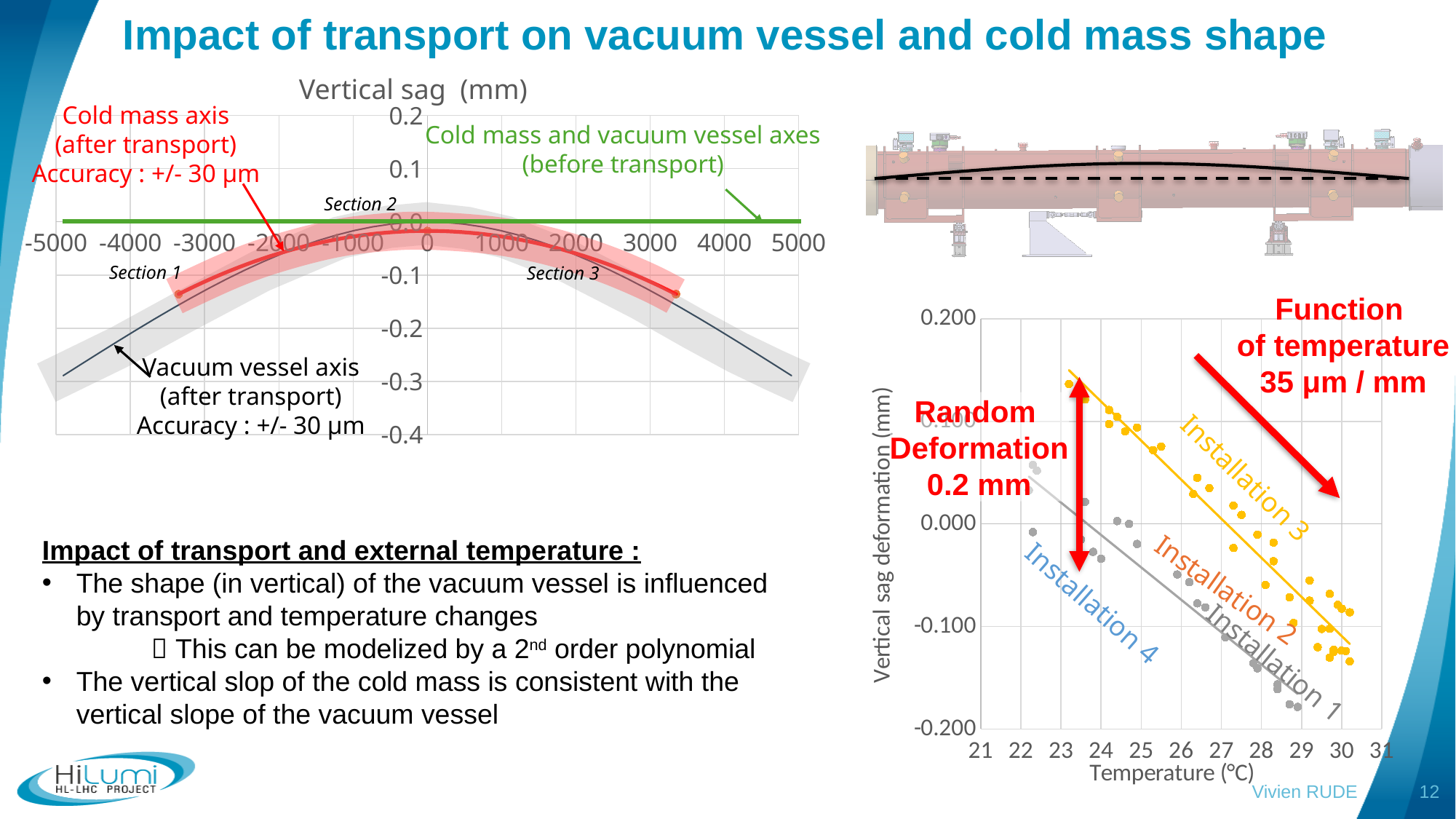
In the right chart, how many installations are labelled? 4 In the left chart, is the cold mass axis (after transport) value at x = 0 greater or less than -0.1? greater What kind of chart is the left chart titled 'Vertical sag (mm)'? line chart In the left chart, what is the highest value shown on the vertical axis? 0.2 In the left chart, what vertical sag value does the green 'Cold mass and vacuum vessel axes (before transport)' line sit at? 0.0 In the right chart, what is the title of the x axis? Temperature (°C) In the right chart, what is the title of the y axis? Vertical sag deformation (mm) In the right chart, do the vertical sag deformation values rise or fall as temperature increases? fall What kind of chart is the right chart plotting vertical sag deformation against temperature? scatter chart In the right chart, at 25 °C, which has the larger vertical sag deformation: Installation 3 or Installation 1? Installation 3 In the left chart, is the vacuum vessel axis (after transport) value at x = -5000 greater or less than -0.2? less